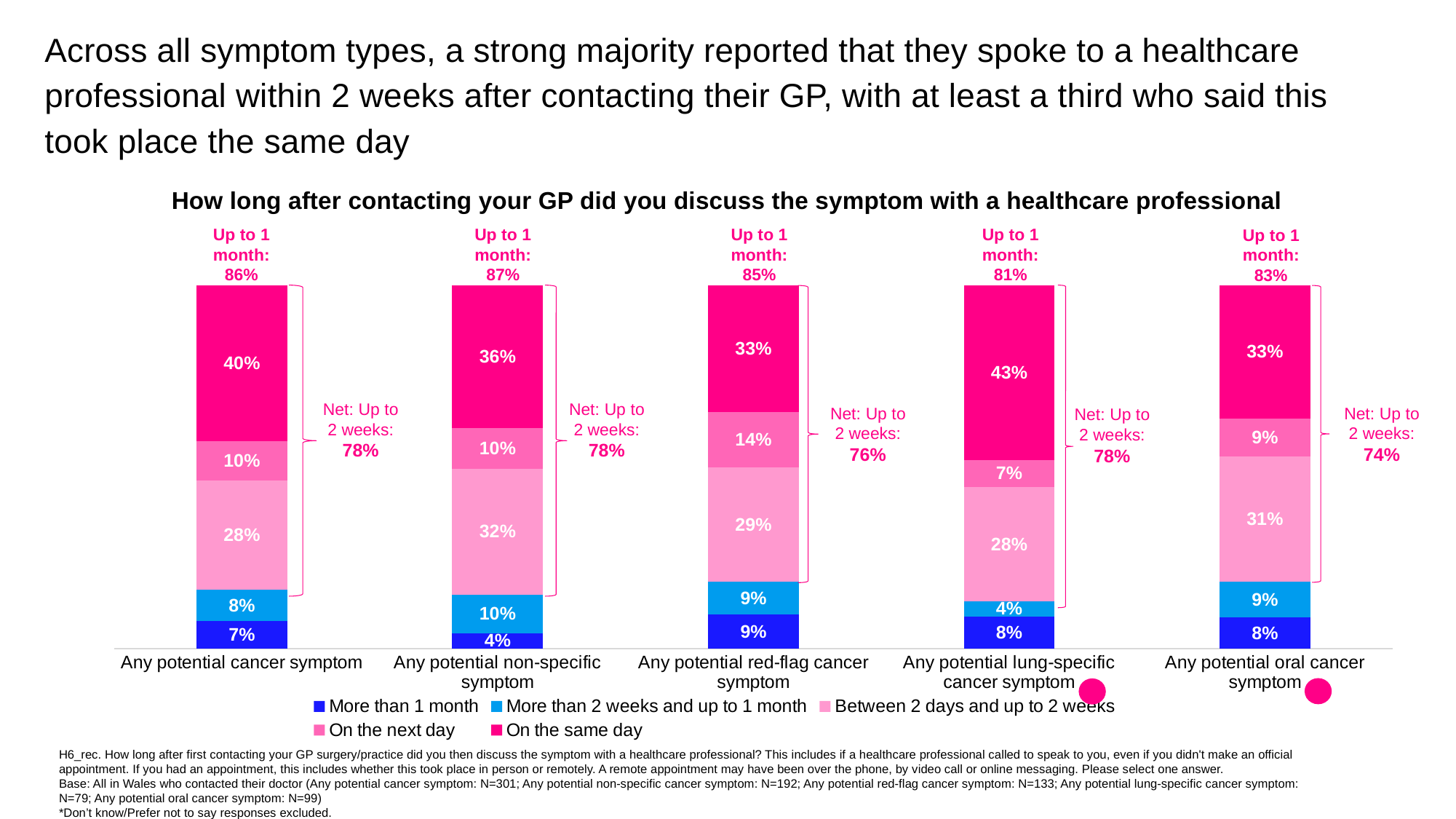
How many symptom categories are shown on the chart? 5 Which symptom category has the highest 'On the same day' percentage? Any potential lung-specific cancer symptom What percentage of respondents with any potential lung-specific cancer symptom discussed the symptom on the same day? 43% What is the 'Up to 1 month' figure for any potential non-specific symptom? 87% What is the title of the chart? How long after contacting your GP did you discuss the symptom with a healthcare professional What is the difference in the 'On the same day' percentage between any potential cancer symptom and any potential red-flag cancer symptom? 7 percentage points Which has the larger 'Between 2 days and up to 2 weeks' percentage: any potential non-specific symptom or any potential lung-specific cancer symptom? Any potential non-specific symptom What is the Net: Up to 2 weeks figure for any potential oral cancer symptom? 74% What percentage of respondents with any potential red-flag cancer symptom discussed the symptom on the next day? 14% Which symptom category has the lowest 'More than 1 month' percentage? Any potential non-specific symptom How many series does the legend list? 5 What kind of chart is shown on the slide? Stacked bar chart